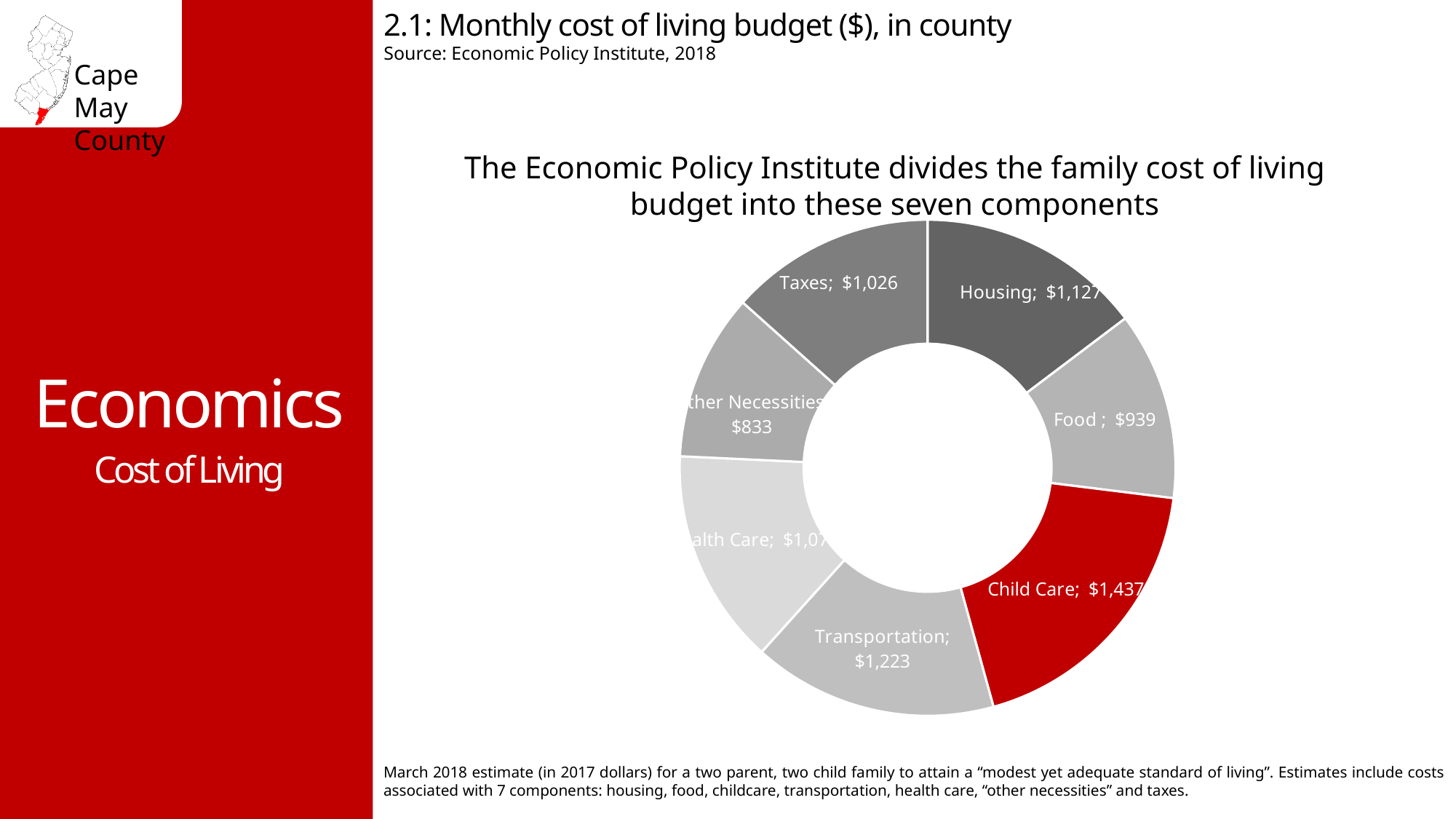
What is the monthly cost for Child Care? $1,437 What is the monthly cost for Transportation? $1,223 Which component's slice is coloured red in the chart? Child Care How many components (slices) does the chart show? 7 Which is larger, the monthly cost for Food or for Other Necessities? Food How much more is the monthly cost for Transportation than for Taxes? $197 What is the monthly cost for Other Necessities? $833 Which component has the largest monthly cost? Child Care What is the monthly cost for Taxes? $1,026 Which component has the smallest monthly cost? Other Necessities What type of chart is shown on the slide? Doughnut (pie) chart What is the monthly cost for Food? $939